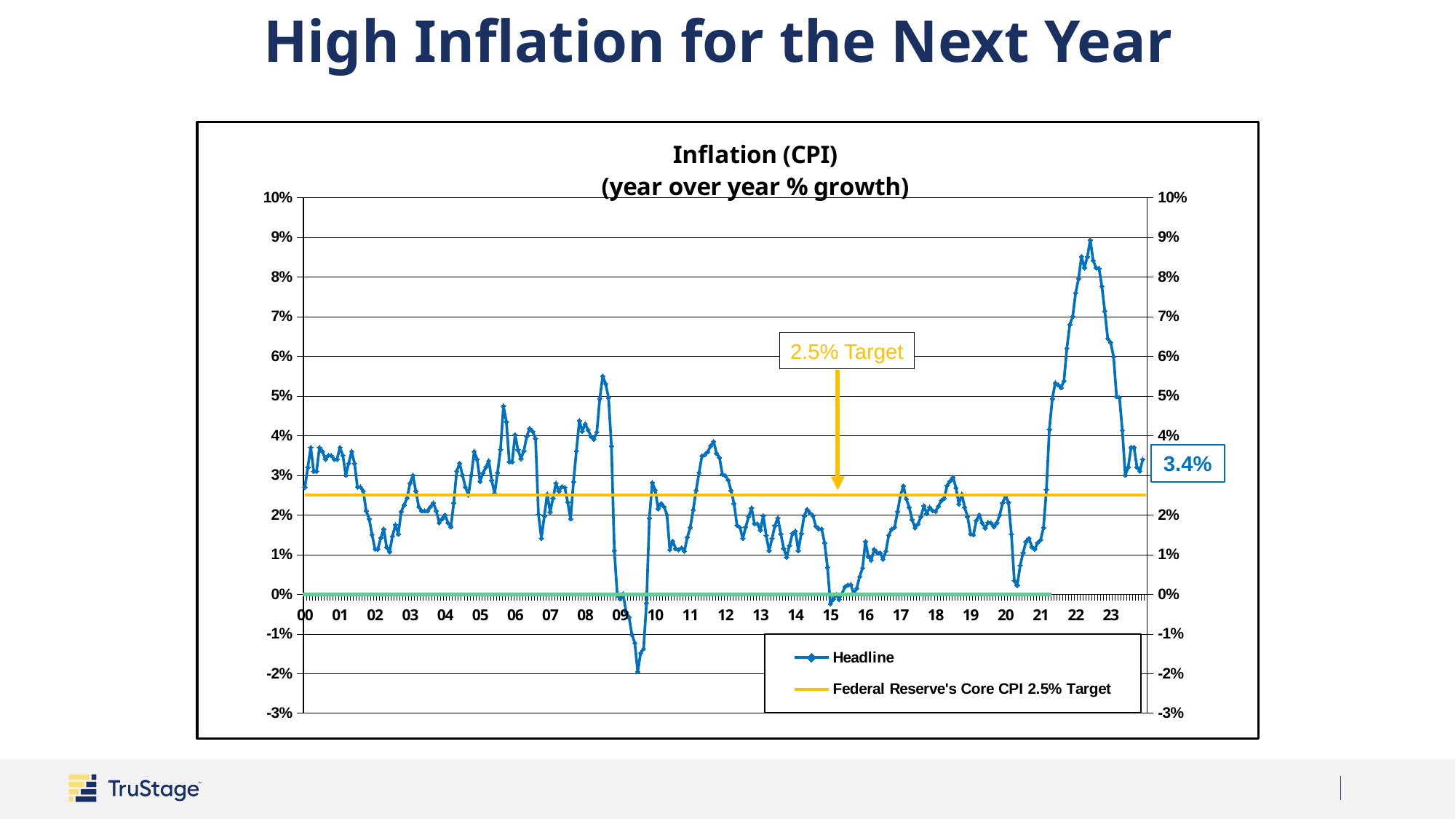
Is the peak Headline inflation value in 2022 greater or less than 8%? greater Is the lowest Headline inflation value around 2009 greater or less than -1%? less What kind of chart is shown on the slide? line chart What is the Federal Reserve's Core CPI target shown on the chart? 2.5% In which year does Headline inflation reach its highest point? 2022 What is the difference between the latest Headline value of 3.4% and the 2.5% target? 0.9% What is the title of the chart? Inflation (CPI) (year over year % growth) What is the most recent Headline inflation value labelled on the chart? 3.4% In which year does Headline inflation reach its lowest point? 2009 Does Headline inflation rise or fall from its 2022 peak to 2023? fall Which is larger, the latest Headline inflation value or the Federal Reserve's 2.5% target? the latest Headline value (3.4%) How many series does the legend list? 2